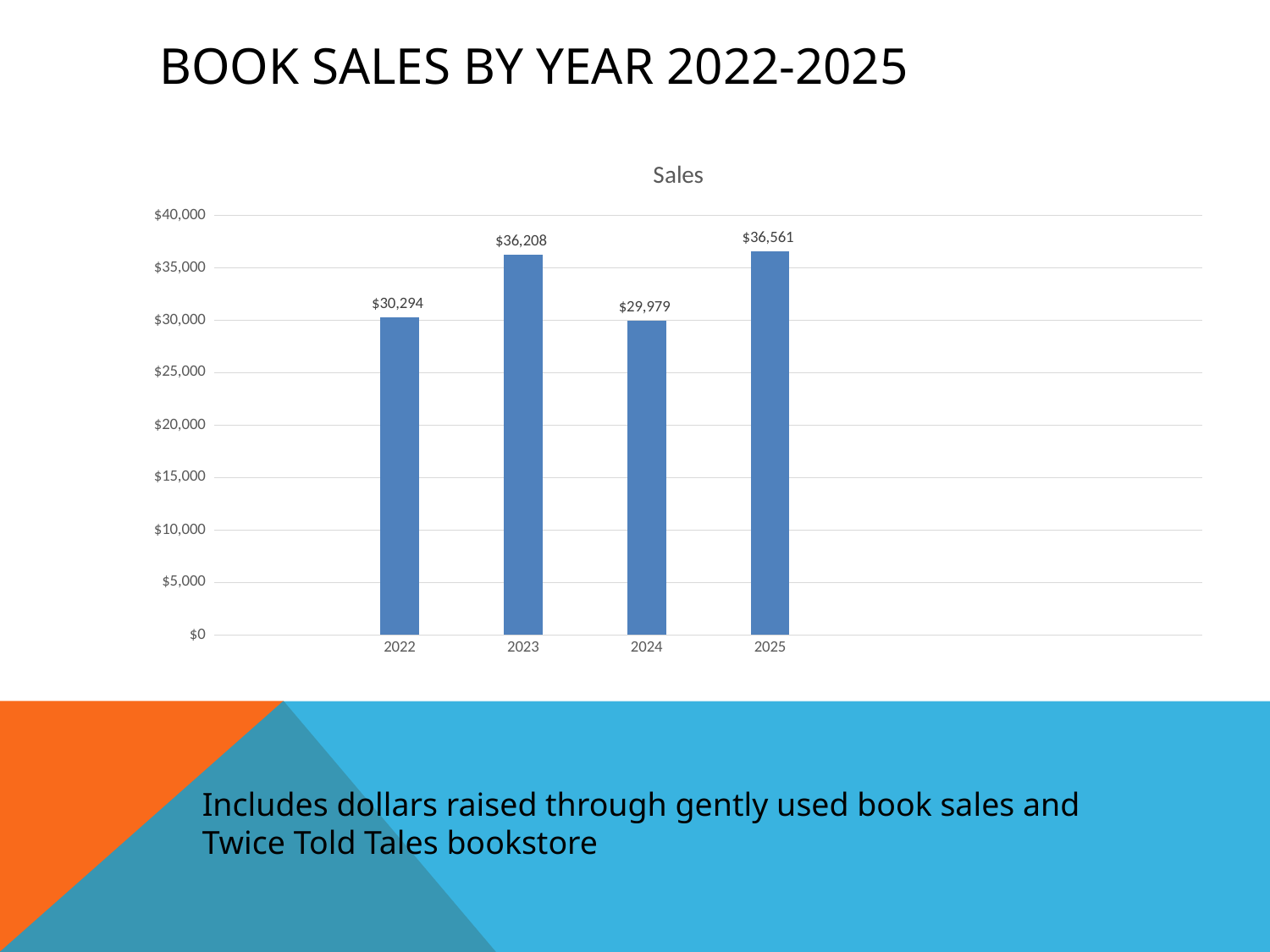
What is the title of the chart? Sales What were the sales in 2024? $29,979 Which year had higher sales, 2022 or 2023? 2023 What kind of chart is shown on the slide? Bar chart What were the sales in 2023? $36,208 How many years are shown in the chart? 4 Which year had the highest sales? 2025 Which year had the lowest sales? 2024 What is the difference in sales between 2023 and 2022? $5,914 What is the difference in sales between 2025 and 2024? $6,582 What were the sales in 2025? $36,561 What were the sales in 2022? $30,294